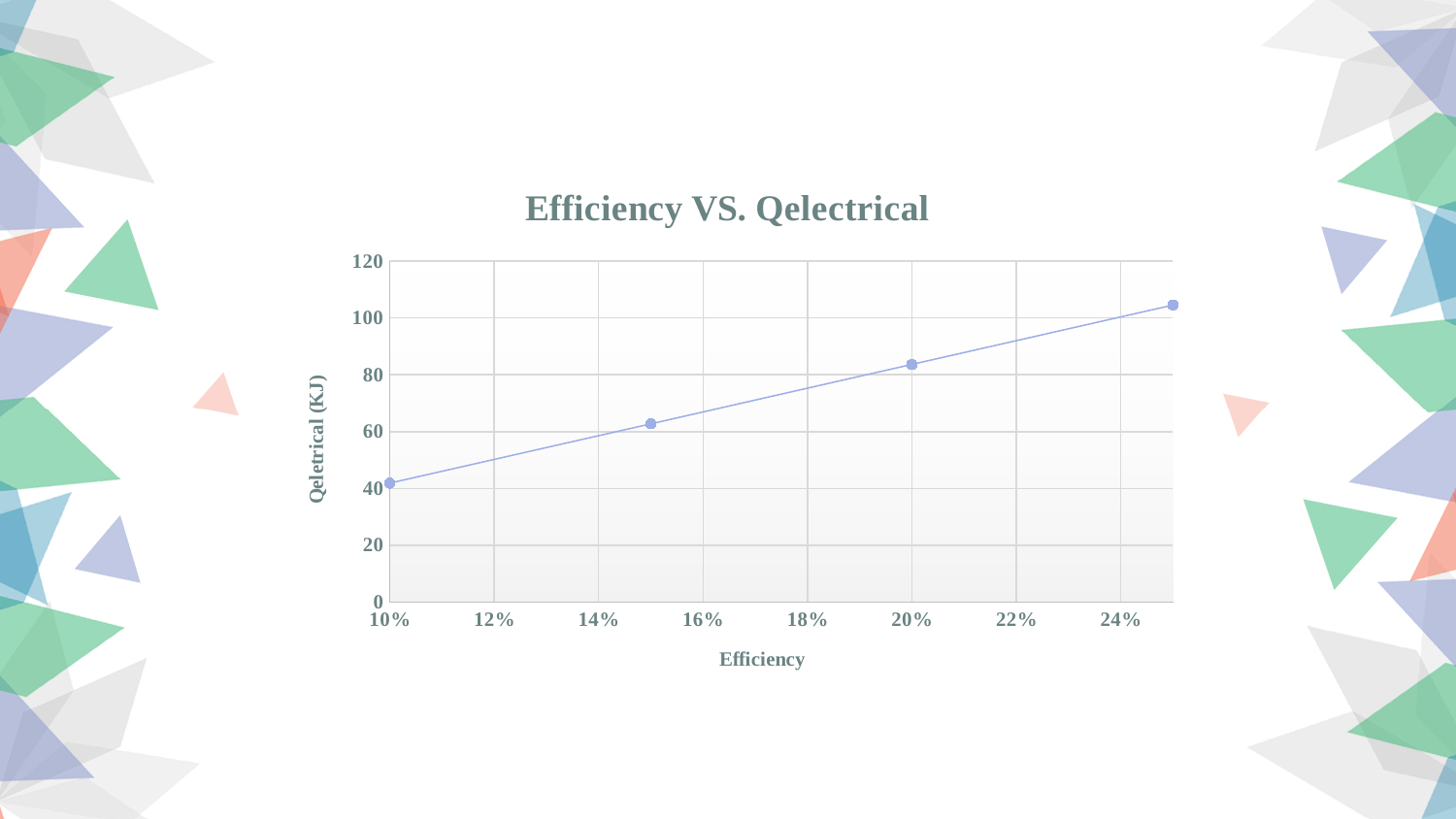
What is the label of the vertical axis? Qeletrical (KJ) Which has the larger Qelectrical value, 15% efficiency or 20% efficiency? 20% Is the Qelectrical value at 20% efficiency greater or less than 60? greater Do the Qelectrical values rise or fall as Efficiency increases along the x axis? rise What kind of chart is shown on the slide? line chart At which Efficiency value is Qelectrical highest? 25% Is the Qelectrical value at 15% efficiency greater or less than 80? less How many data points are plotted on the chart? 4 At which Efficiency value is Qelectrical lowest? 10% Is the Qelectrical value at 10% efficiency greater or less than 60? less What is the title of the chart? Efficiency VS. Qelectrical